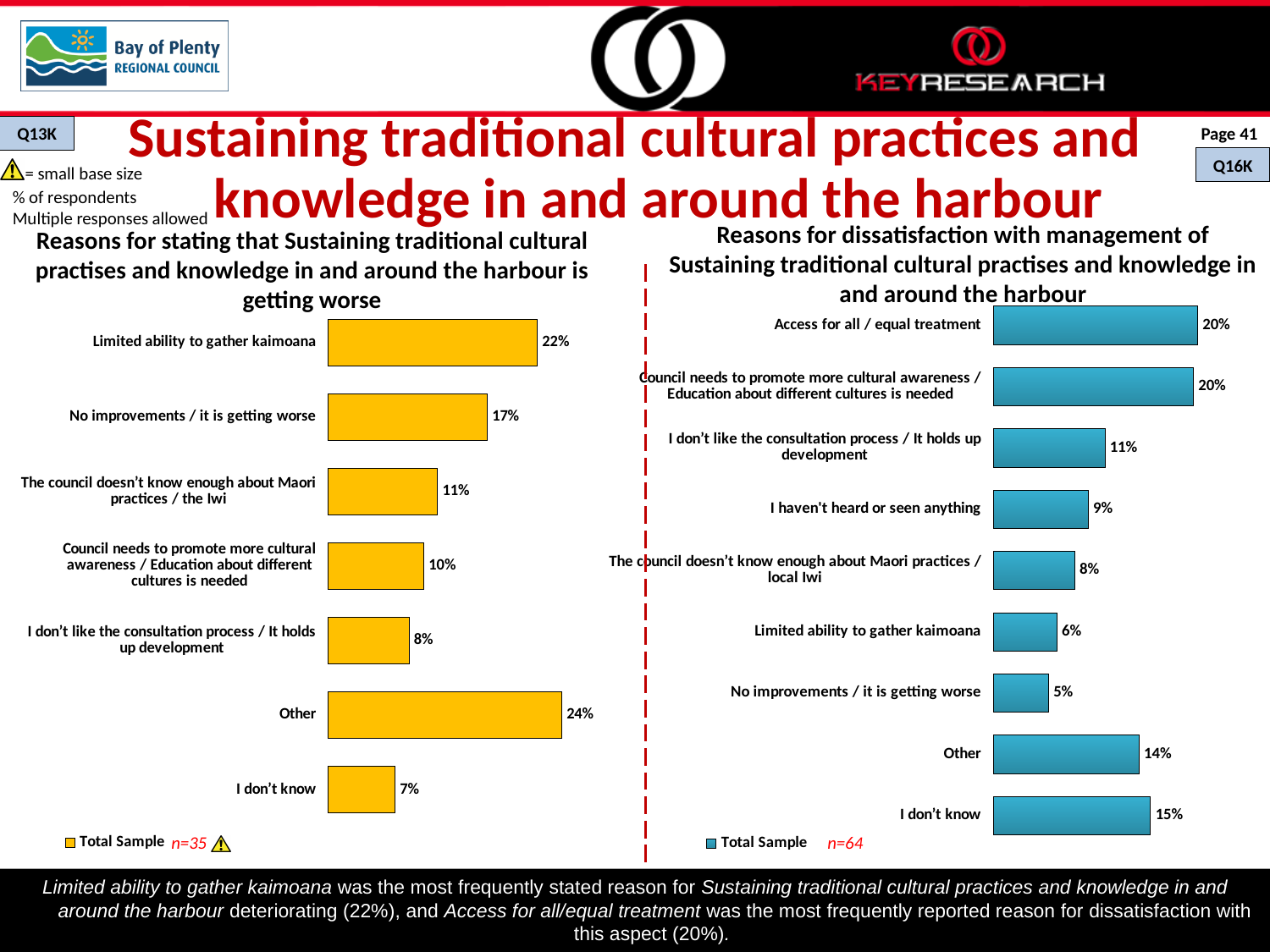
In the right chart (reasons for dissatisfaction with management), which category has the lowest value? No improvements / it is getting worse In the left chart (reasons for getting worse), which category has the lowest value? I don't know What type of chart is used on the right (reasons for dissatisfaction with management)? Bar chart In the left chart (reasons for getting worse), what is the difference between 'Limited ability to gather kaimoana' and 'No improvements / it is getting worse'? 5% How many categories are shown in the left chart (reasons for getting worse)? 7 How many categories are shown in the right chart (reasons for dissatisfaction with management)? 9 In the right chart (reasons for dissatisfaction with management), what is the difference between 'I don't know' and 'Other'? 1% In the left chart (reasons for getting worse), what is the value for 'Limited ability to gather kaimoana'? 22% In the left chart (reasons for getting worse), which category has the highest value? Other In the right chart (reasons for dissatisfaction with management), what is the value for 'Access for all / equal treatment'? 20% In the right chart (reasons for dissatisfaction with management), which is larger: 'I don't like the consultation process / It holds up development' or 'I haven't heard or seen anything'? I don't like the consultation process / It holds up development What is the sample size (n) shown for the right chart (reasons for dissatisfaction with management)? n=64